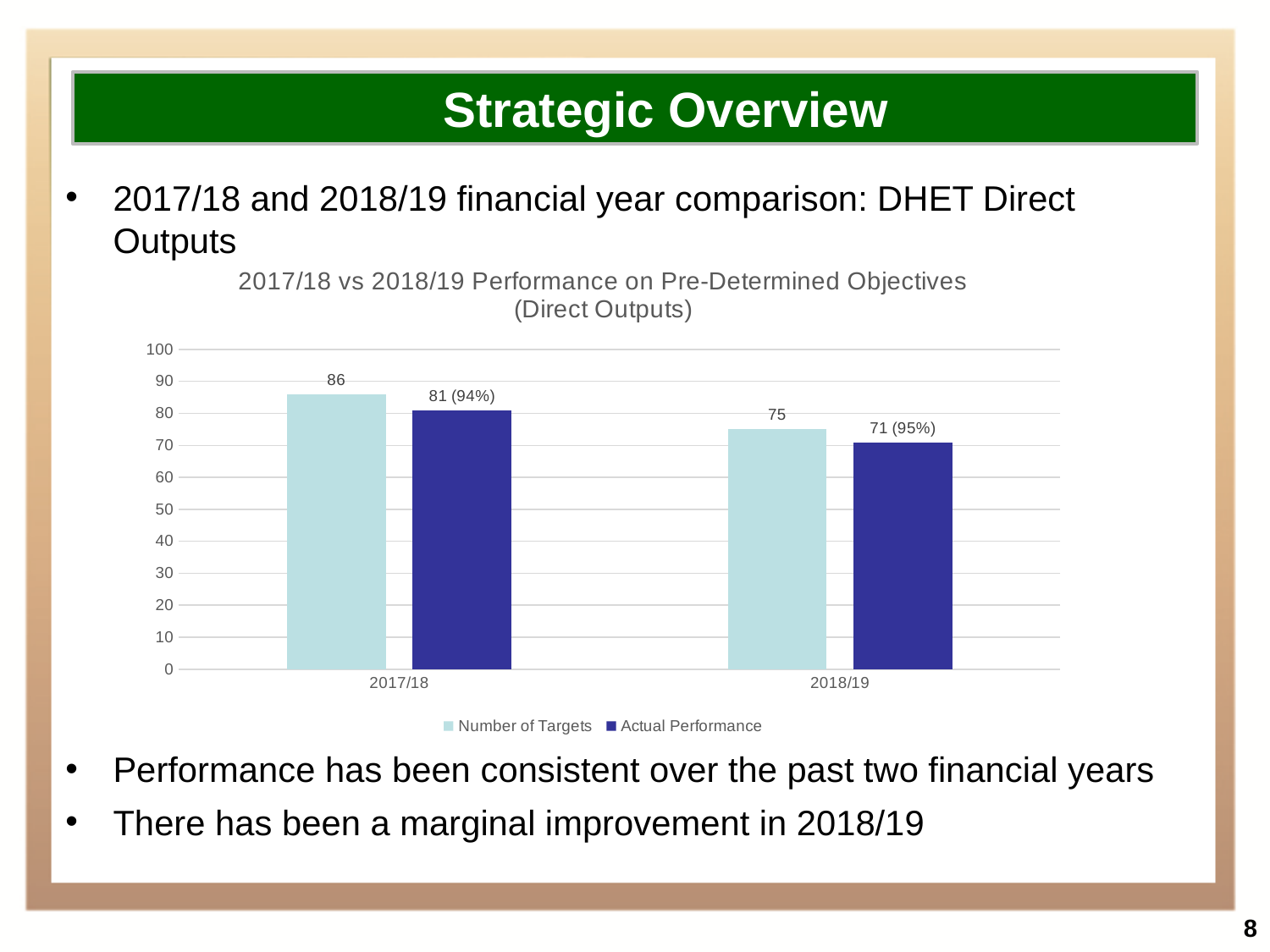
What is the title of the chart? 2017/18 vs 2018/19 Performance on Pre-Determined Objectives (Direct Outputs) Is the Actual Performance for 2017/18 greater or less than the Number of Targets for 2018/19? greater Which year has the lower Actual Performance? 2018/19 What is the Actual Performance value for 2018/19? 71 (95%) What is the Number of Targets for 2018/19? 75 How many series does the legend list? 2 What is the difference between the Number of Targets in 2017/18 and 2018/19? 11 How many categories are shown on the x axis? 2 What kind of chart is shown on the slide? bar chart What is the Actual Performance value for 2017/18? 81 (94%) What is the Number of Targets for 2017/18? 86 Which year has the higher Number of Targets? 2017/18